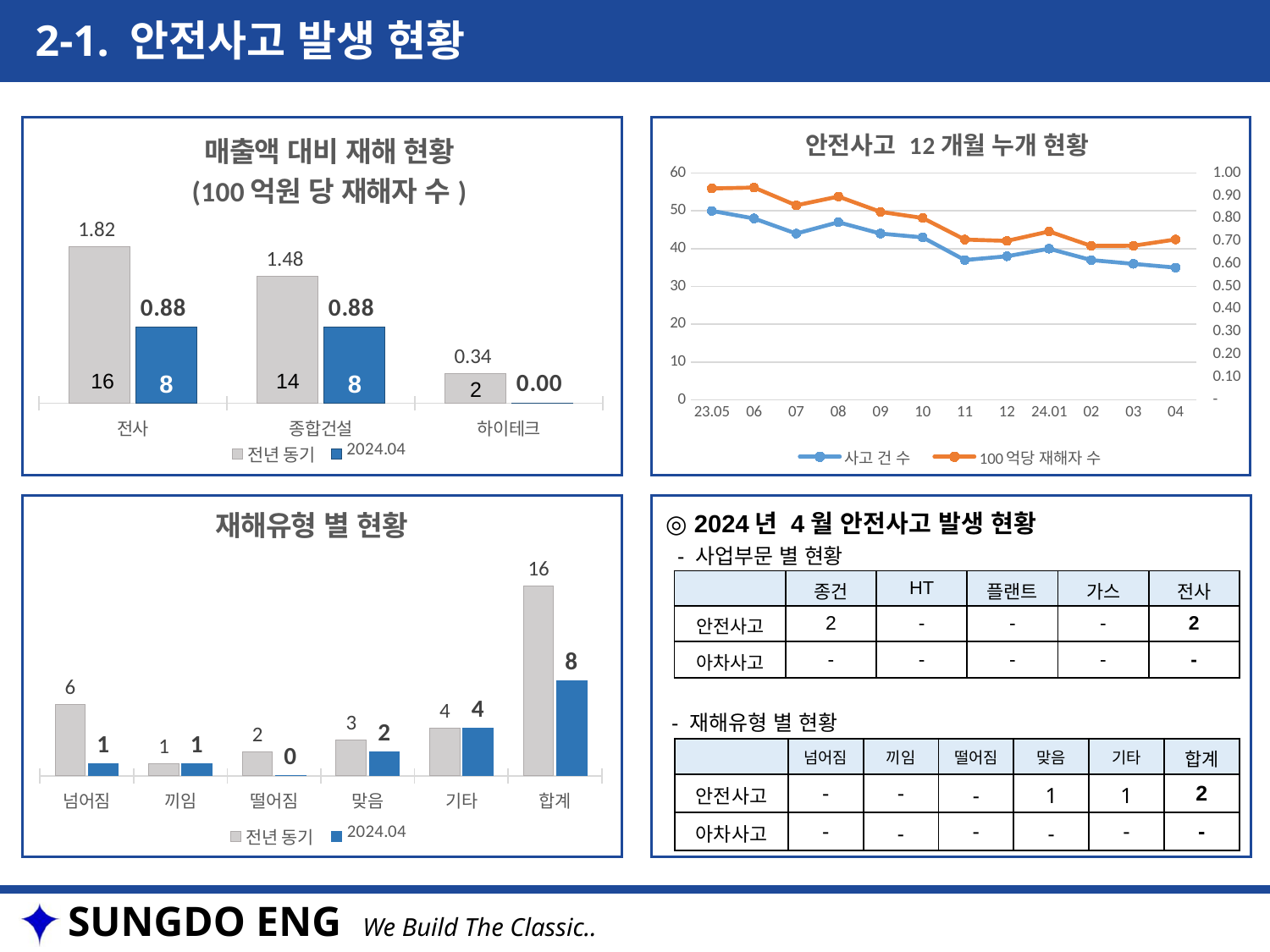
In the chart titled 재해유형 별 현황, what is the difference between the 전년 동기 and 2024.04 values for 합계? 8 What kind of chart is the one titled 안전사고 12개월 누개 현황? line chart In the chart titled 재해유형 별 현황, how many categories are shown on the x axis? 6 In the chart titled 재해유형 별 현황, what is the 전년 동기 value for 넘어짐? 6 In the chart titled 매출액 대비 재해 현황, what is the 전년 동기 value for 전사? 1.82 In the chart titled 안전사고 12개월 누개 현황, is the 사고 건 수 value for 04 (2024) greater or less than 40? less In the chart titled 매출액 대비 재해 현황, which category has the highest 전년 동기 value? 전사 In the chart titled 안전사고 12개월 누개 현황, do the 사고 건 수 values generally rise or fall from 23.05 to 24.04? fall In the chart titled 재해유형 별 현황, what is the 2024.04 value for 기타? 4 In the chart titled 재해유형 별 현황, which category has the lowest 2024.04 value? 떨어짐 In the chart titled 매출액 대비 재해 현황, what is the difference between the 전년 동기 and 2024.04 values for 종합건설? 0.60 In the chart titled 매출액 대비 재해 현황, what is the 2024.04 value for 하이테크? 0.00